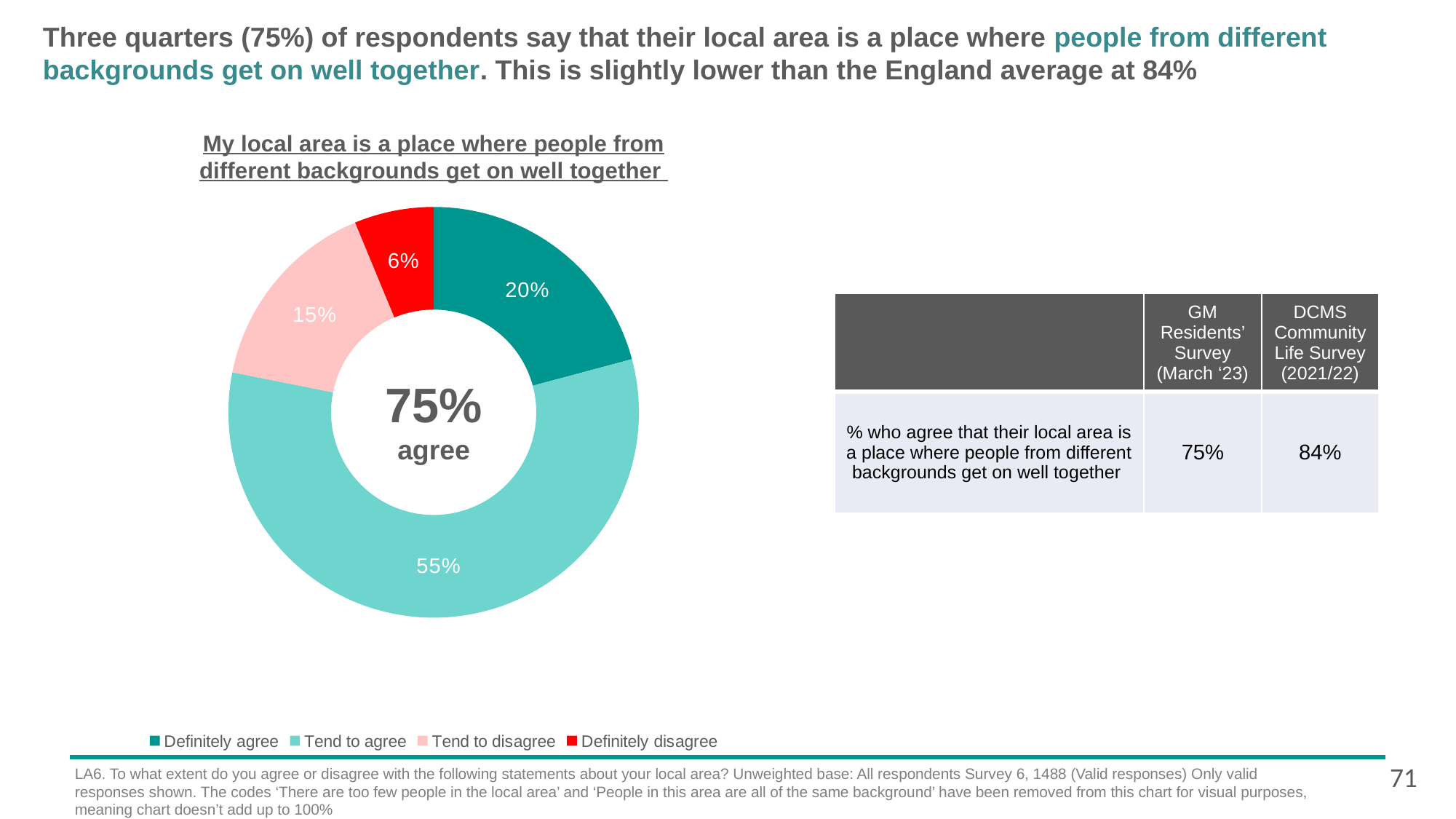
How many response categories does the legend of the doughnut chart list? 4 What is the difference in percentage points between 'Tend to agree' and 'Definitely agree'? 35 Which response category has the largest share in the doughnut chart? Tend to agree What type of chart is used to show the responses to 'My local area is a place where people from different backgrounds get on well together'? Doughnut (pie) chart Which is larger: the share for 'Tend to disagree' or the share for 'Definitely disagree'? Tend to disagree What percentage of respondents 'Definitely disagree' in the doughnut chart? 6% What combined percentage is shown in the centre of the doughnut chart as agreeing? 75% agree Which response category has the smallest share in the doughnut chart? Definitely disagree What percentage of respondents 'Tend to agree' that their local area is a place where people from different backgrounds get on well together? 55% What percentage of respondents 'Definitely agree' in the doughnut chart? 20% What percentage of respondents 'Tend to disagree' in the doughnut chart? 15% What colour represents 'Definitely disagree' in the doughnut chart? Red